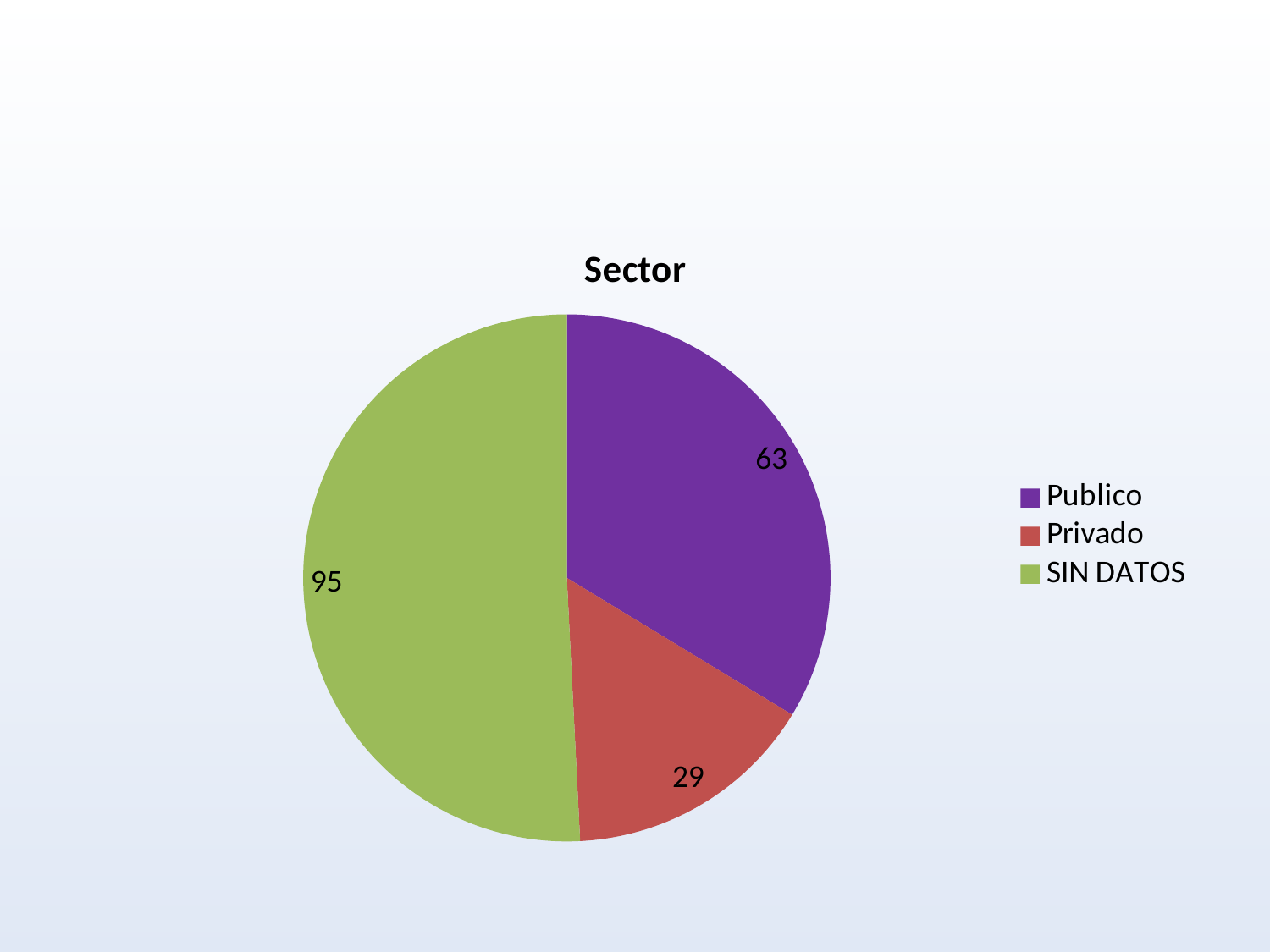
What is the difference between the values for SIN DATOS and Publico? 32 What is the total of all slices in the Sector pie chart? 187 What is the title of the chart? Sector What is the difference between the values for Publico and Privado? 34 How many categories are shown in the Sector pie chart? 3 What is the value for Privado in the Sector pie chart? 29 Which category has the largest slice in the Sector pie chart? SIN DATOS What is the value for Publico in the Sector pie chart? 63 Which category has the smallest slice in the Sector pie chart? Privado What type of chart is shown on the slide? Pie chart What is the value for SIN DATOS in the Sector pie chart? 95 Which is larger, the value for Publico or the value for Privado? Publico